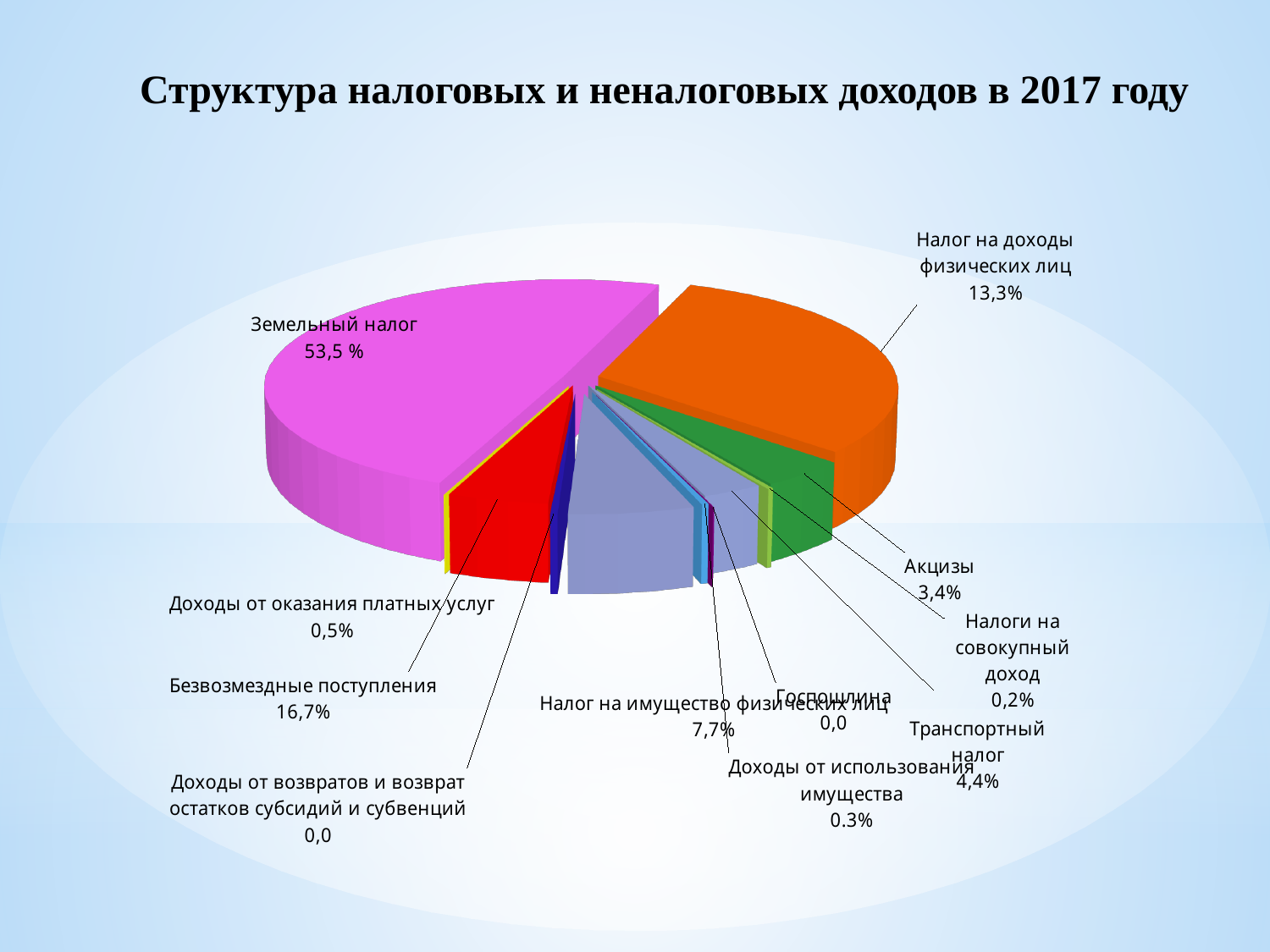
What kind of chart is shown on the slide? pie chart What is the value shown for Акцизы? 3,4% What is the value shown for Безвозмездные поступления? 16,7% Which category has the largest share of the pie? Земельный налог What is the value shown for Транспортный налог? 4,4% What is the value shown for Доходы от оказания платных услуг? 0,5% What is the value shown for Налог на доходы физических лиц? 13,3% What is the difference between the shares of Земельный налог and Безвозмездные поступления? 36,8% What share does Земельный налог have in the pie? 53,5 % How many categories are labelled in the pie chart? 11 What is the title of the chart? Структура налоговых и неналоговых доходов в 2017 году